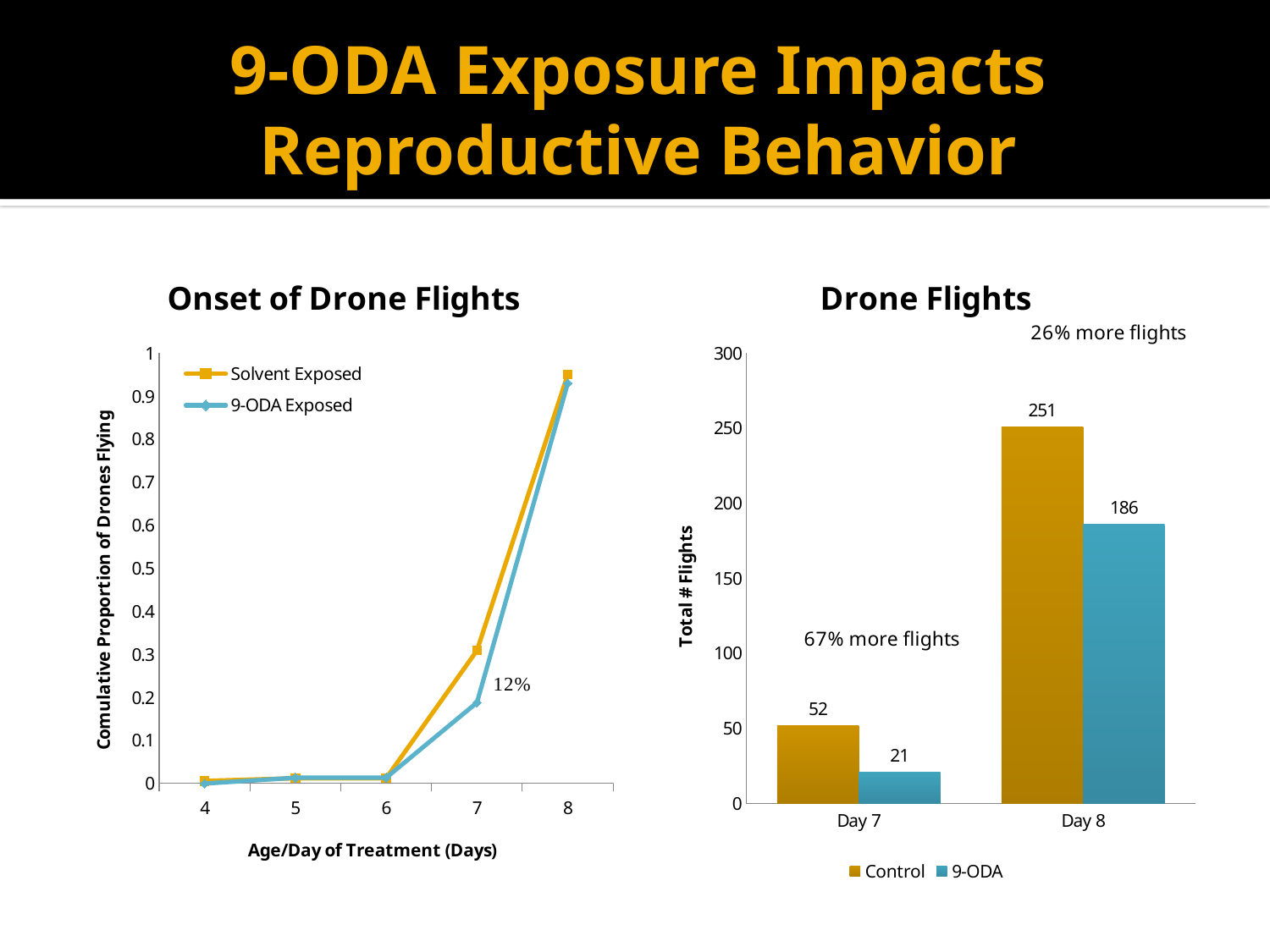
In the "Onset of Drone Flights" chart, how many points are on the x axis? 5 In the "Drone Flights" chart, what is the value for 9-ODA on Day 8? 186 In the "Onset of Drone Flights" chart, is the value for Solvent Exposed at day 7 greater or less than 0.2? greater In the "Drone Flights" chart, what is the value for 9-ODA on Day 7? 21 In the "Drone Flights" chart, how many series does the legend list? 2 In the "Drone Flights" chart, which bar is the lowest? 9-ODA, Day 7 In the "Drone Flights" chart, which is larger on Day 7, Control or 9-ODA? Control In the "Drone Flights" chart, what is the value for Control on Day 7? 52 What kind of chart is the "Drone Flights" chart? bar chart In the "Drone Flights" chart, which bar is the highest? Control, Day 8 In the "Drone Flights" chart, what is the difference between Control and 9-ODA on Day 8? 65 What kind of chart is the "Onset of Drone Flights" chart? line chart